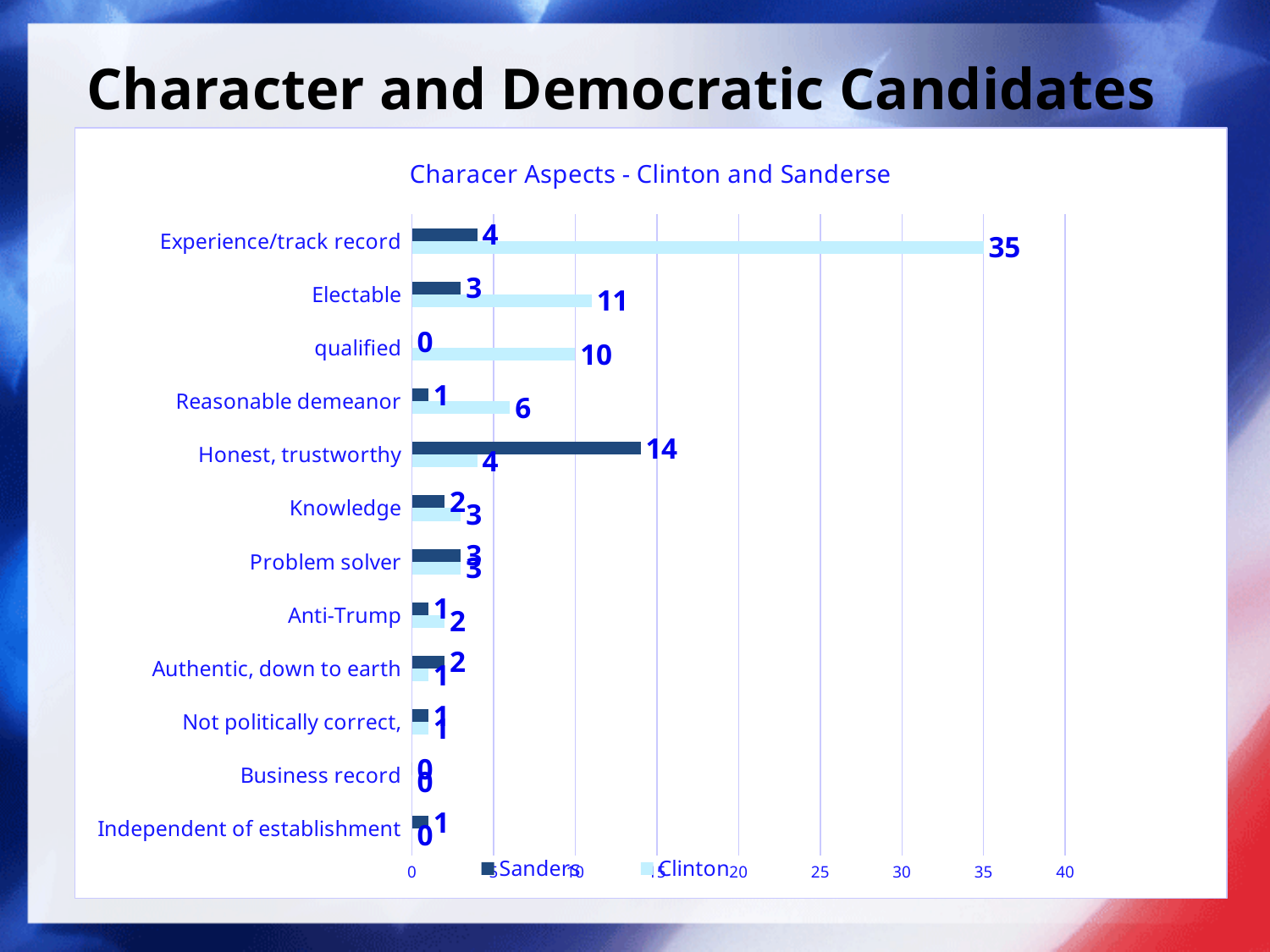
How many series does the legend list? 2 For Honest, trustworthy, which is larger: the Sanders value or the Clinton value? Sanders How many categories are shown on the chart? 12 What is the Sanders value for qualified? 0 What is the difference between the Clinton and Sanders values for Experience/track record? 31 What is the Sanders value for Honest, trustworthy? 14 What is the Clinton value for Experience/track record? 35 What kind of chart is shown on the slide? Bar chart Which category has the highest Sanders value? Honest, trustworthy What is the Clinton value for Electable? 11 Is the Clinton value for Experience/track record greater or less than 30? greater Which category has the highest Clinton value? Experience/track record